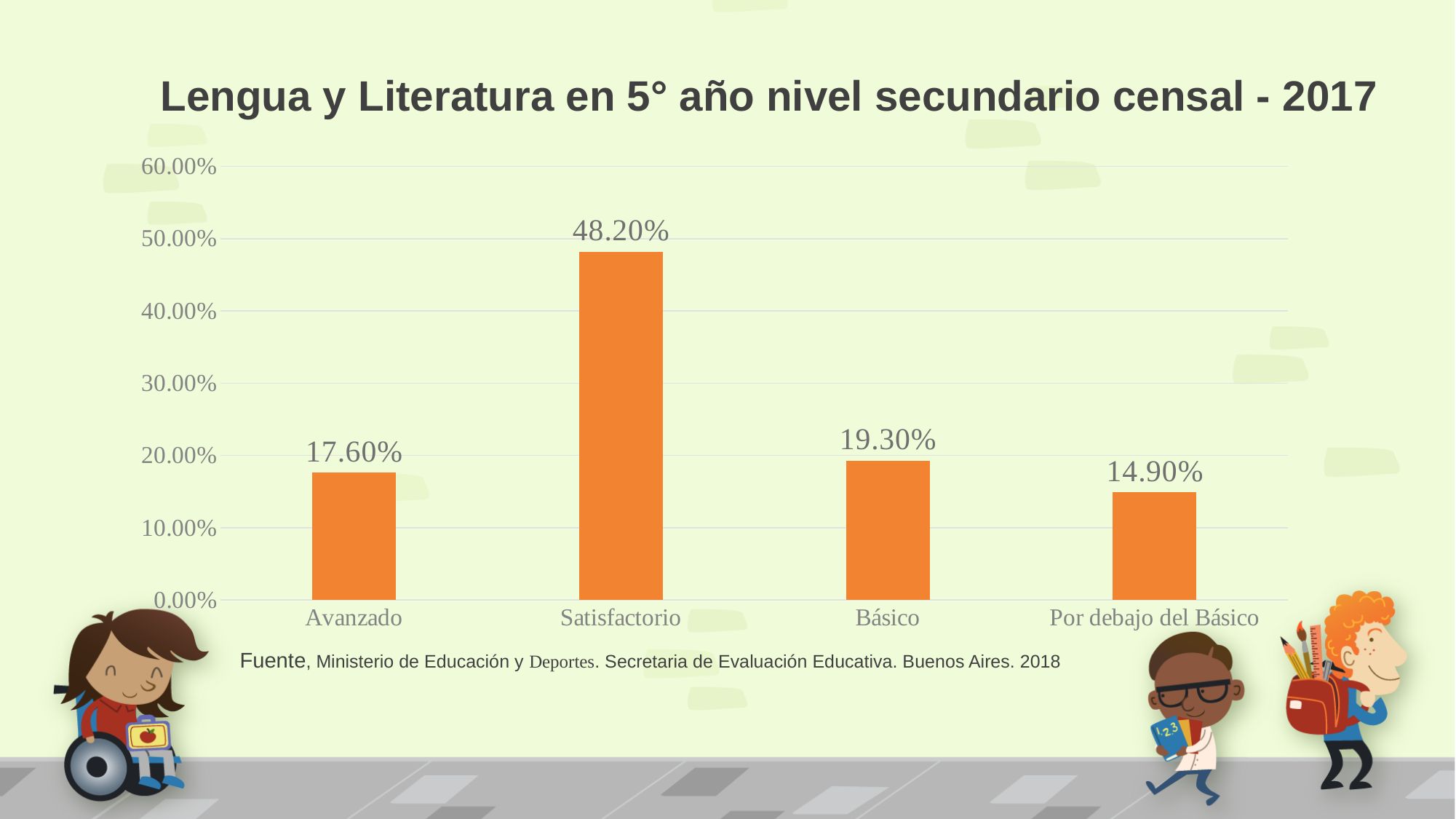
What is the difference between the values for Satisfactorio and Básico? 28.90% What is the title of the chart? Lengua y Literatura en 5° año nivel secundario censal - 2017 Which category has the highest value? Satisfactorio Is the value for Satisfactorio greater or less than 40.00%? greater How many categories are shown on the x axis? 4 What kind of chart is shown on the slide? Bar chart What is the value for Avanzado? 17.60% Which category has the lowest value? Por debajo del Básico Which is larger, the value for Avanzado or the value for Por debajo del Básico? Avanzado What is the value for Por debajo del Básico? 14.90% What is the difference between the values for Básico and Avanzado? 1.70% What is the value for Satisfactorio? 48.20%